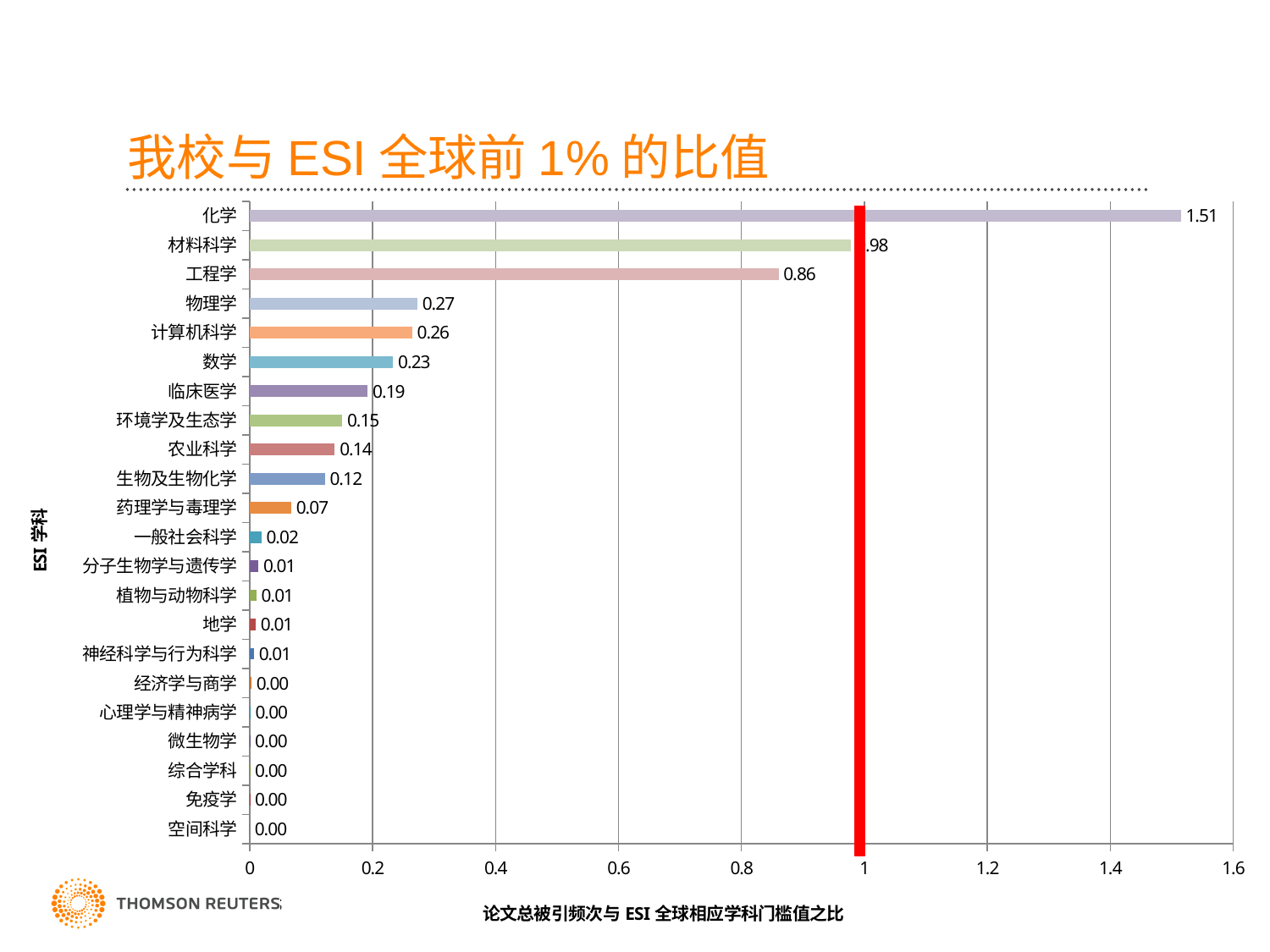
Which category has the highest value? 化学 What is the value for 药理学与毒理学? 0.07 What is the title of the chart on the slide? 我校与 ESI 全球前 1% 的比值 What is the value for 数学? 0.23 What kind of chart is shown on the slide? bar chart What is the difference between the values for 化学 and 工程学? 0.65 How many categories are shown on the chart? 22 Which is larger, the value for 临床医学 or the value for 农业科学? 临床医学 Is the value for 材料科学 greater or less than 1? less What is the difference between the values for 物理学 and 计算机科学? 0.01 What is the value for 化学? 1.51 What is the value for 工程学? 0.86